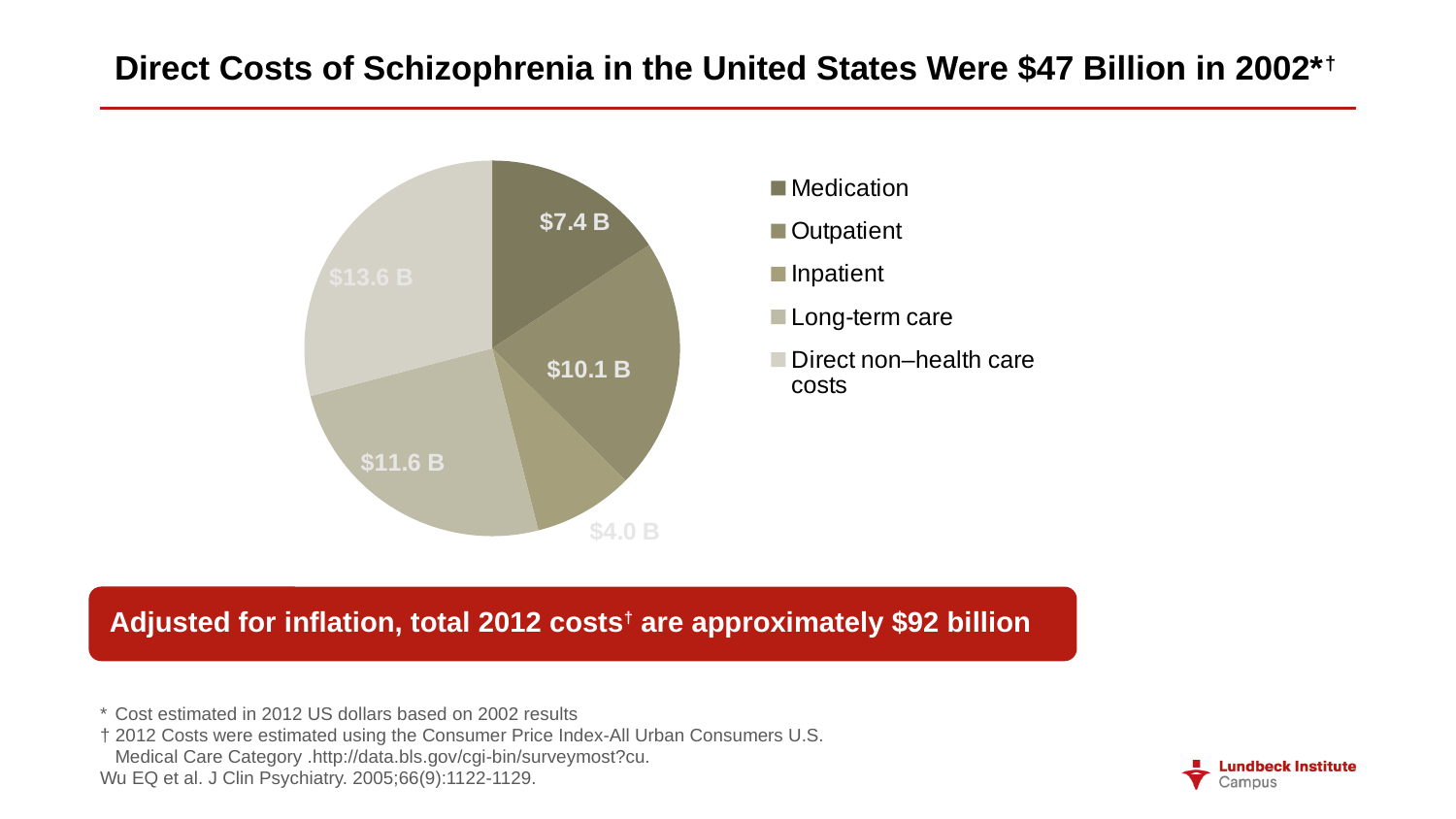
What type of chart is shown on the slide? Pie chart How many categories does the legend list? 5 Which category has the smallest slice of the pie? Inpatient What is the value shown for Long-term care? $11.6 B Which is larger, the Outpatient value or the Long-term care value? Long-term care What is the value shown for Inpatient? $4.0 B What is the value shown for Outpatient? $10.1 B What is the value shown for Direct non–health care costs? $13.6 B What is the difference between the Long-term care value and the Medication value? $4.2 B Which category has the largest slice of the pie? Direct non–health care costs What is the title of the slide containing the chart? Direct Costs of Schizophrenia in the United States Were $47 Billion in 2002 What is the value shown for Medication? $7.4 B